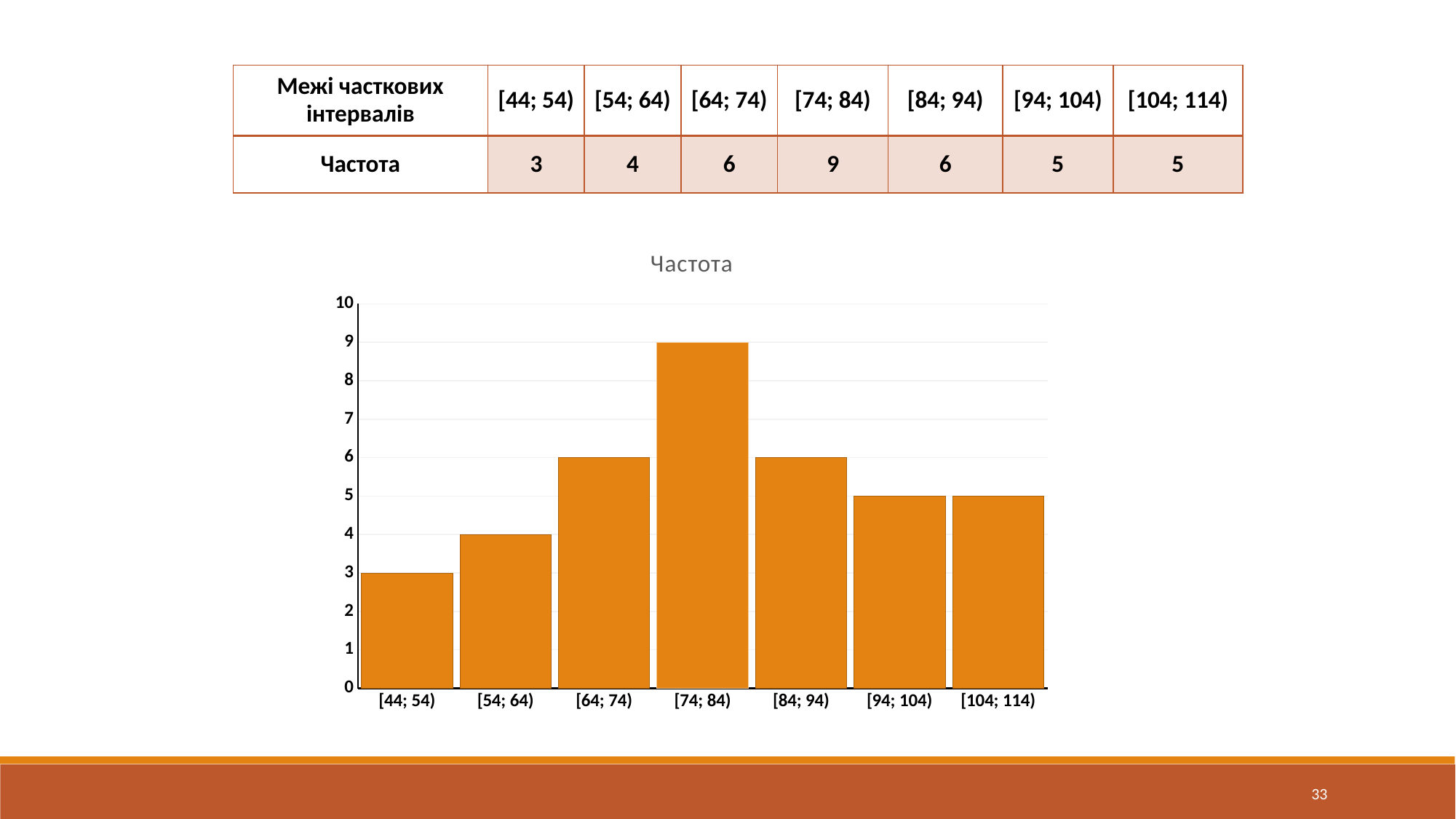
What is the title of the chart? Частота How many intervals are shown on the x axis of the chart? 7 Do the frequencies rise or fall from [44; 54) to [74; 84)? rise Which has a larger frequency, [64; 74) or [94; 104)? [64; 74) What is the frequency for the interval [104; 114)? 5 What is the frequency for the interval [44; 54)? 3 What is the difference between the frequency of [74; 84) and the frequency of [54; 64)? 5 Which interval has the lowest frequency? [44; 54) Is the frequency for [84; 94) greater or less than 5? greater What is the frequency (Частота) for the interval [74; 84)? 9 Which interval has the highest frequency? [74; 84) What kind of chart is shown on the slide? bar chart